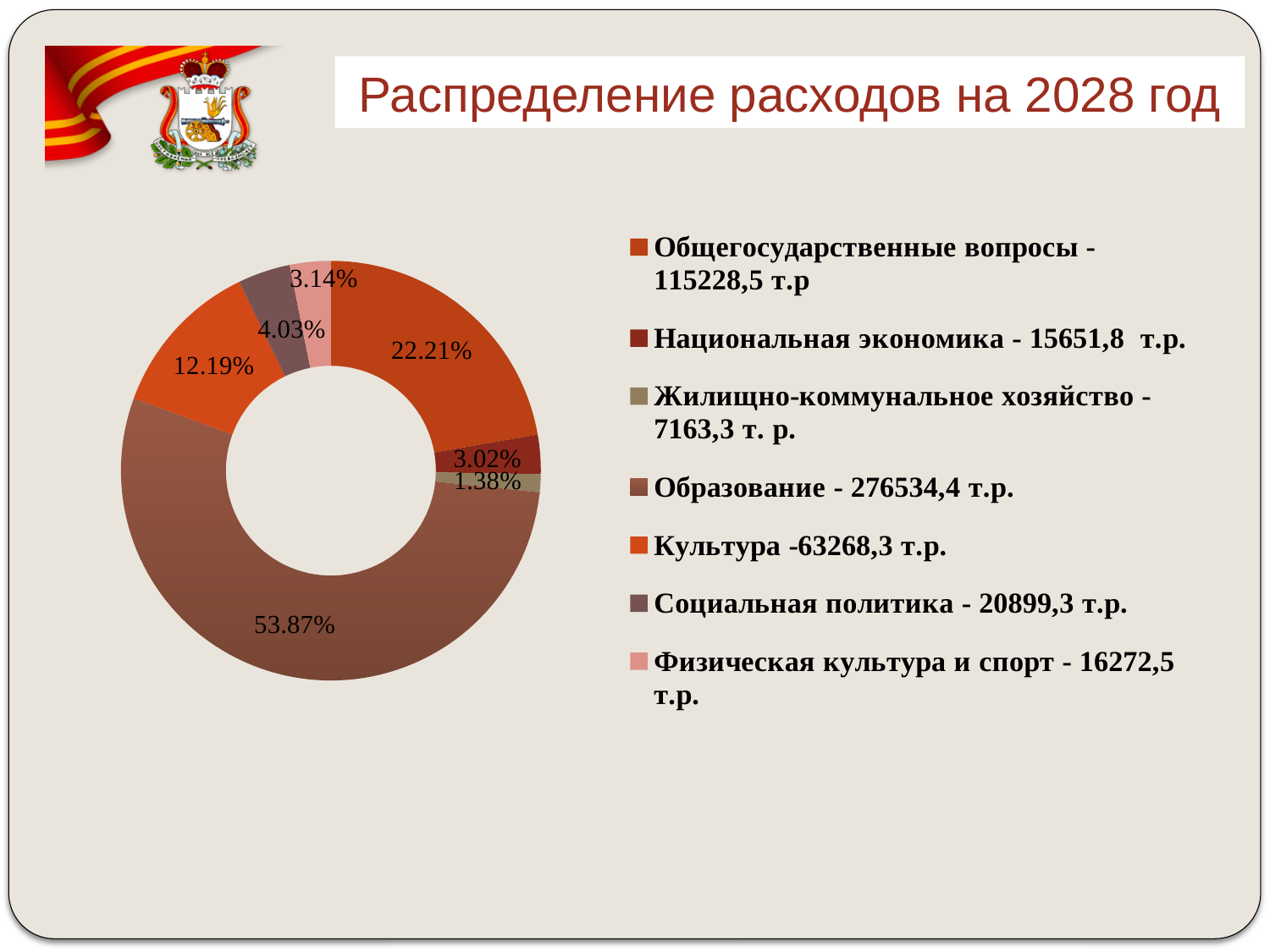
What kind of chart is shown on the slide? Doughnut (pie) chart How many categories does the legend list? 7 What is the title of the chart on the slide? Распределение расходов на 2028 год Which category has the smallest share of the chart? Жилищно-коммунальное хозяйство What is the difference in percentage points between the shares of Образование and Общегосударственные вопросы? 31.66 Which category has the largest share of the chart? Образование According to the legend, what is the amount for Образование? 276534,4 т.р. What share of the chart does Общегосударственные вопросы take? 22.21% Which has a larger share: Социальная политика or Физическая культура и спорт? Социальная политика According to the legend, what is the amount for Национальная экономика? 15651,8 т.р. What share of the chart does Культура take? 12.19% What share of the chart does Образование take? 53.87%